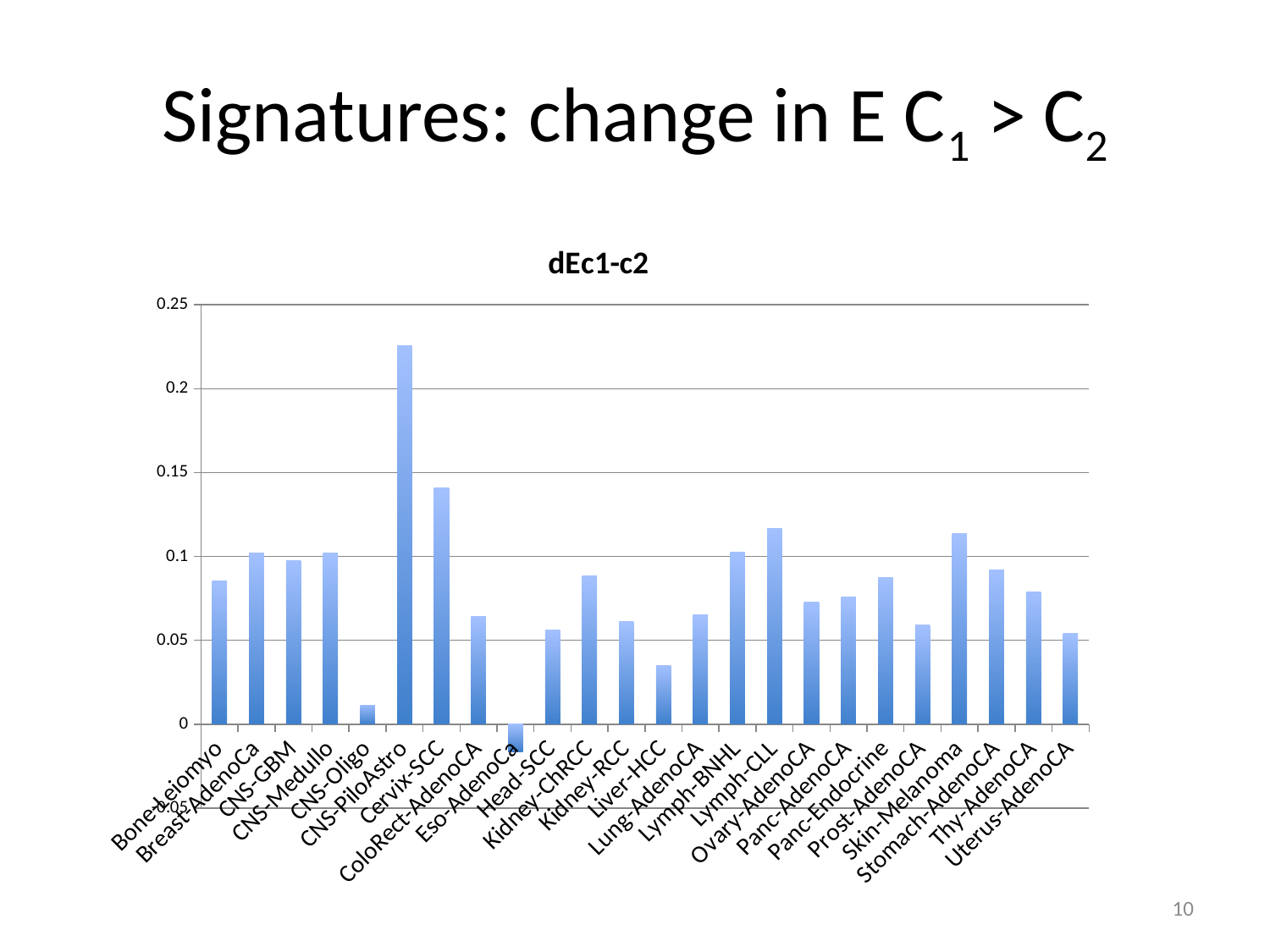
Is the value for Cervix-SCC greater or less than 0.1? greater Which category has the lowest value in the chart? Eso-AdenoCa Is the value for Liver-HCC greater or less than 0.05? less Which category is the only one with a negative value? Eso-AdenoCa Which category has the highest value in the chart? CNS-PiloAstro What kind of chart is shown on the slide? Bar chart Which has the larger value, Liver-HCC or Lymph-CLL? Lymph-CLL Is the value for CNS-PiloAstro greater or less than 0.2? greater What is the title of the chart? dEc1-c2 How many categories are plotted on the x axis of the chart? 24 Which has the larger value, CNS-PiloAstro or Cervix-SCC? CNS-PiloAstro